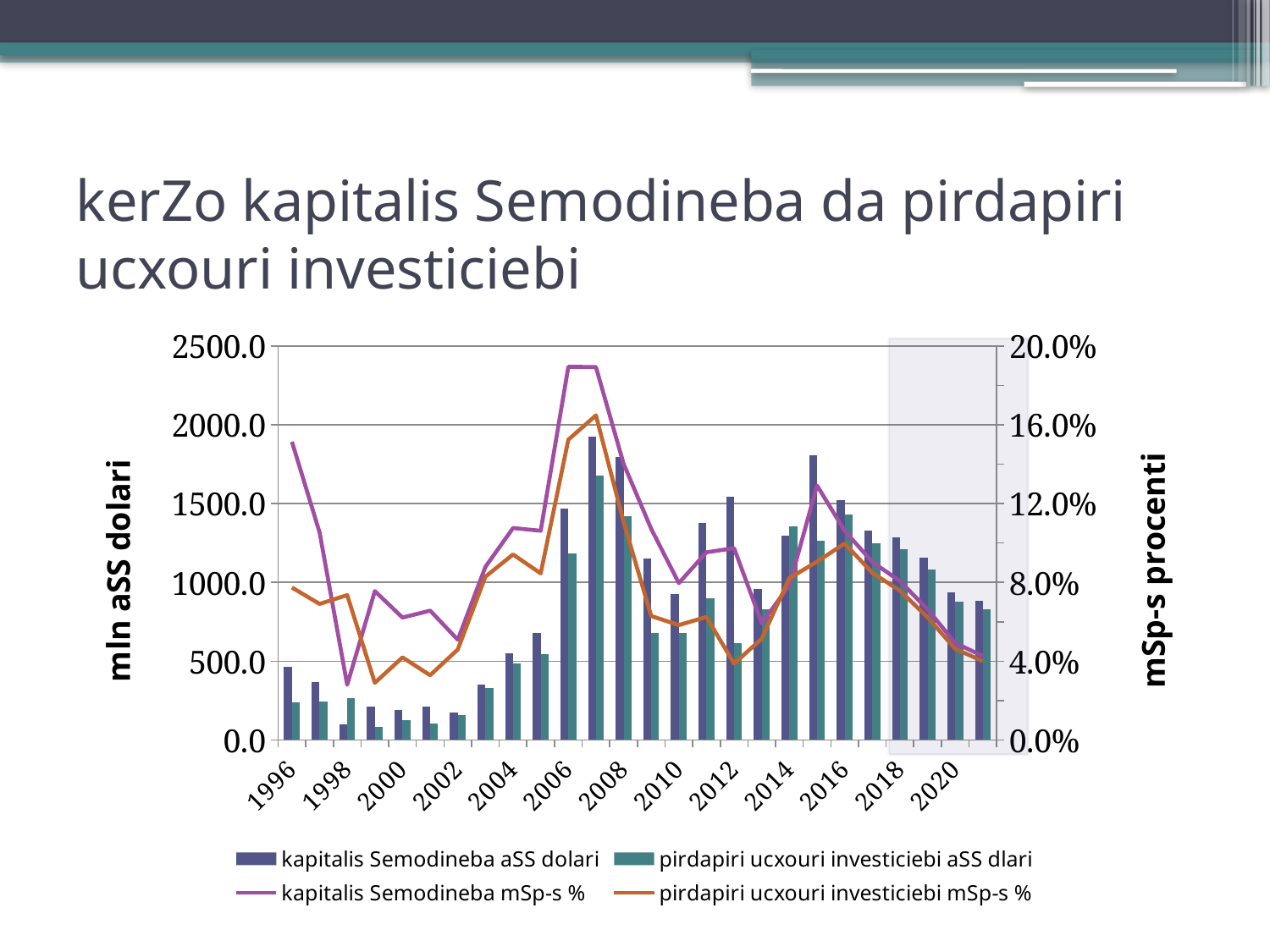
Is the 'kapitalis Semodineba mSp-s %' line value for 2007 greater or less than 16.0%? greater Is the 'kapitalis Semodineba aSS dolari' bar for 2007 greater or less than 1500.0? greater What is the title of the right-hand vertical axis? mSp-s procenti In which year does the 'pirdapiri ucxouri investiciebi mSp-s %' line reach its highest point? 2007 In which year is the 'kapitalis Semodineba aSS dolari' bar the highest? 2007 Is the 'kapitalis Semodineba aSS dolari' bar for 2007 greater or less than 2000.0? less Which is larger, the 'kapitalis Semodineba aSS dolari' bar for 2007 or for 2015? 2007 In which year does the 'kapitalis Semodineba mSp-s %' line reach its lowest point? 1998 How many series does the chart legend list? 4 What kind of chart is shown on the slide? A combination bar and line chart Do the 'kapitalis Semodineba aSS dolari' bars rise or fall from 2017 to 2021? fall